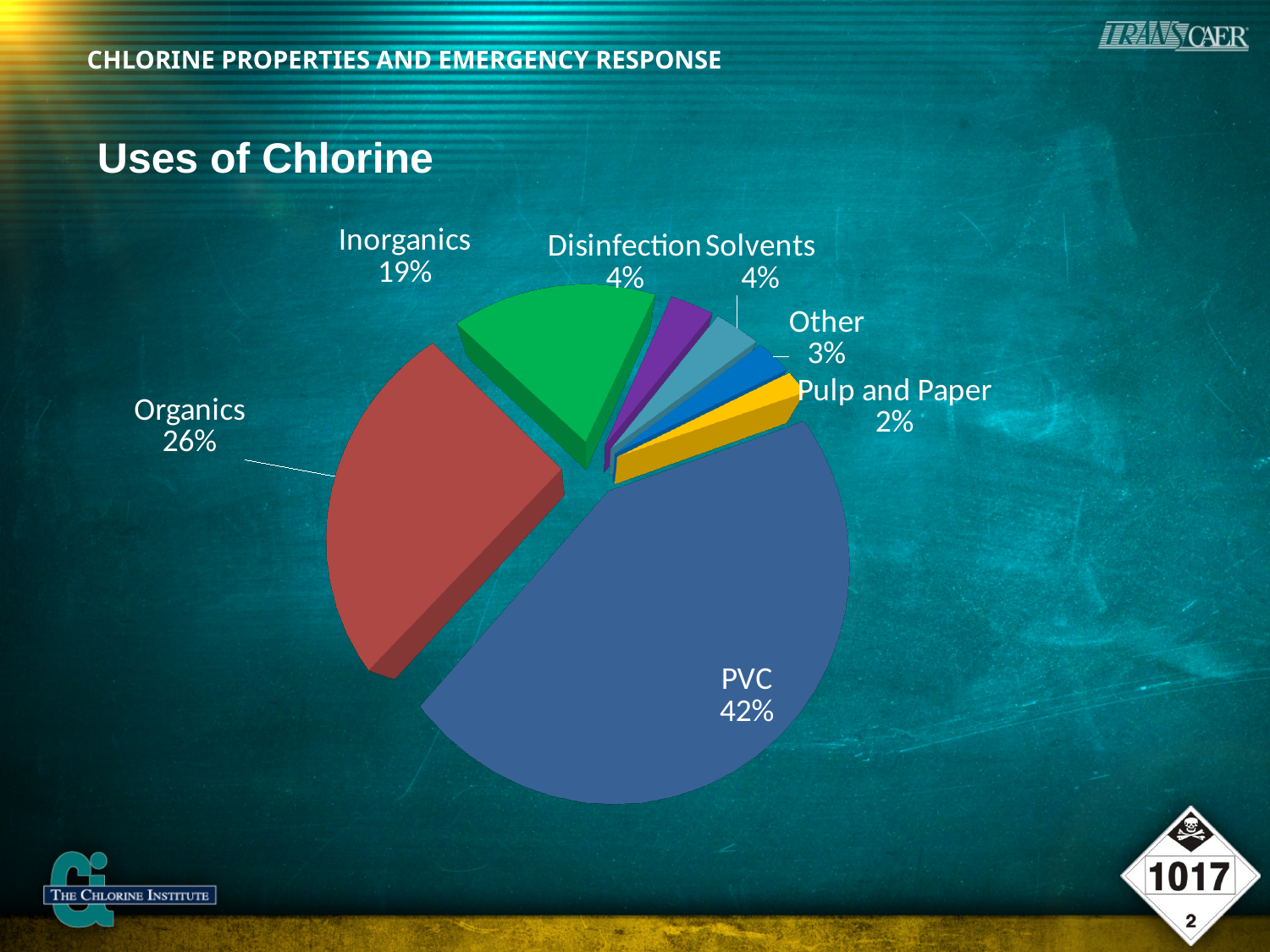
How many slices does the pie chart have? 7 How many percentage points larger is the PVC share than the Organics share? 16 What share is shown for Other? 3% Which use of chlorine has the largest slice of the pie? PVC What kind of chart is shown on the slide? Pie chart What percentage of the pie is labelled Organics? 26% What is the title of the chart on the slide? Uses of Chlorine What percentage is shown for Pulp and Paper? 2% Which is larger, the share for Inorganics or the share for Organics? Organics Which use of chlorine has the smallest slice of the pie? Pulp and Paper What share is shown for Inorganics? 19% What share of chlorine uses does PVC account for? 42%